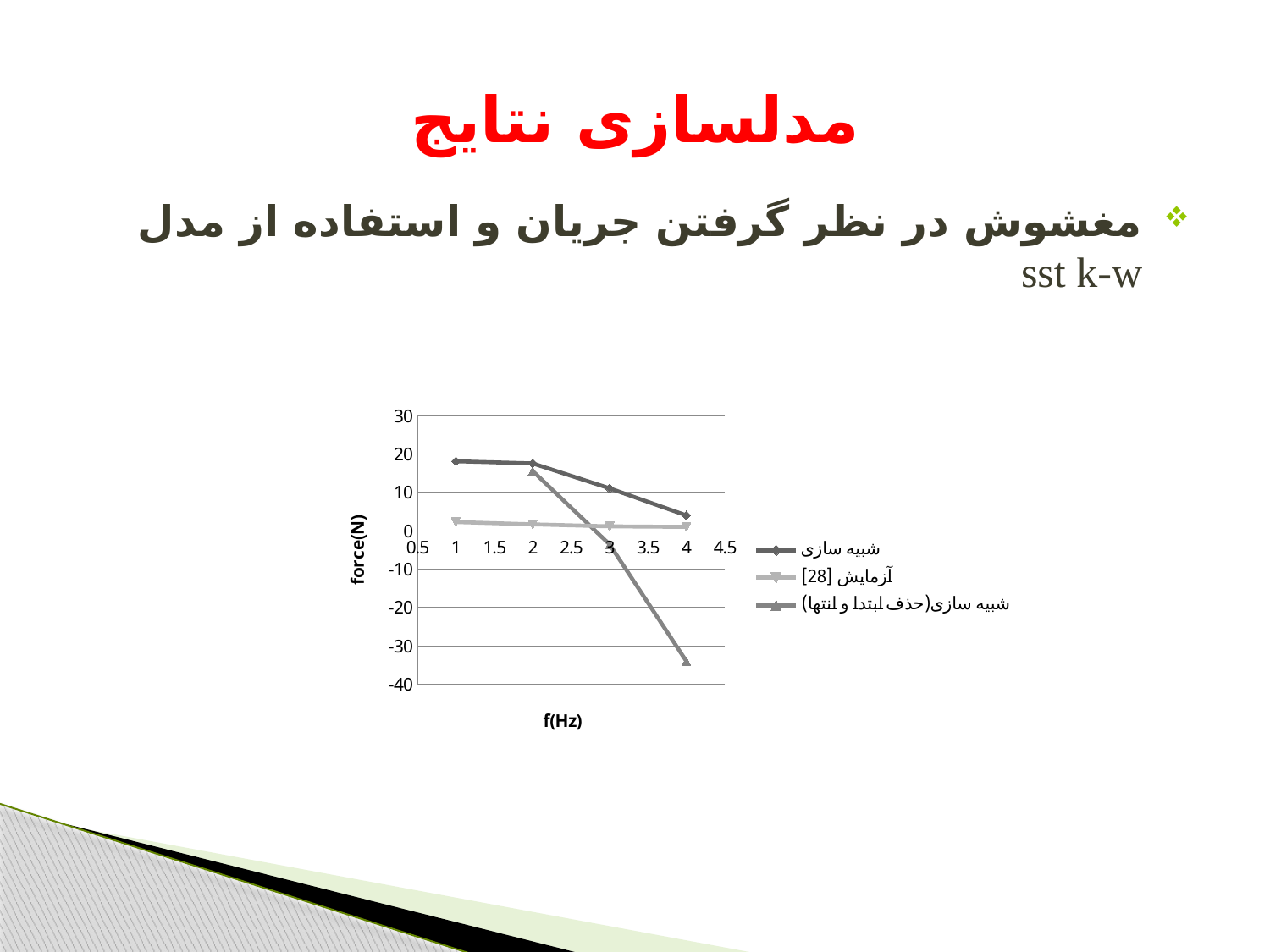
What kind of chart is shown on the slide? line chart Is the value of the شبیه سازی series at f = 4 greater or less than 10? less How many data points are plotted for the شبیه سازی series? 4 How many series does the legend list? 3 Is the value of the شبیه سازی(حذف ابتدا و انتها) series at f = 4 greater or less than -30? less What is the label of the horizontal axis? f(Hz) At f = 4, which series has the larger value: شبیه سازی or شبیه سازی(حذف ابتدا و انتها)? شبیه سازی Does the شبیه سازی series rise or fall as f increases from 1 to 4? fall Which series has the lowest value at f = 4? شبیه سازی(حذف ابتدا و انتها) Is the value of the شبیه سازی series at f = 1 greater or less than 10? greater What is the label of the vertical axis? force(N)